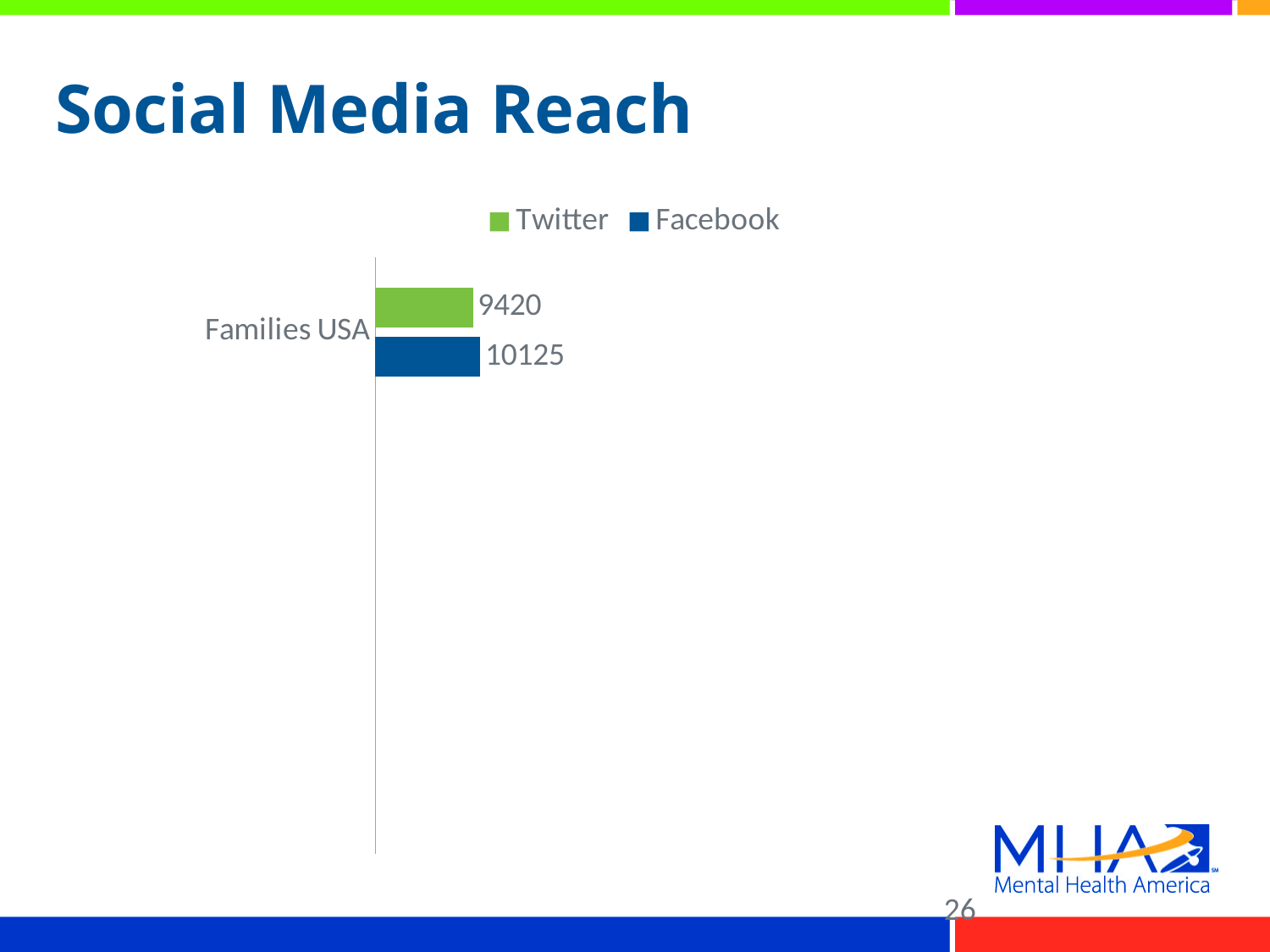
What is the title of the slide containing the chart? Social Media Reach What is the difference between the Facebook and Twitter values for Families USA? 705 What is the Twitter value for Families USA? 9420 What is the name of the category shown on the chart? Families USA How many categories are shown on the chart? 1 What is the Facebook value for Families USA? 10125 How many series does the legend list? 2 What kind of chart is shown on the slide? Bar chart Which colour represents Twitter in the chart? Green Which series has the larger value for Families USA, Twitter or Facebook? Facebook